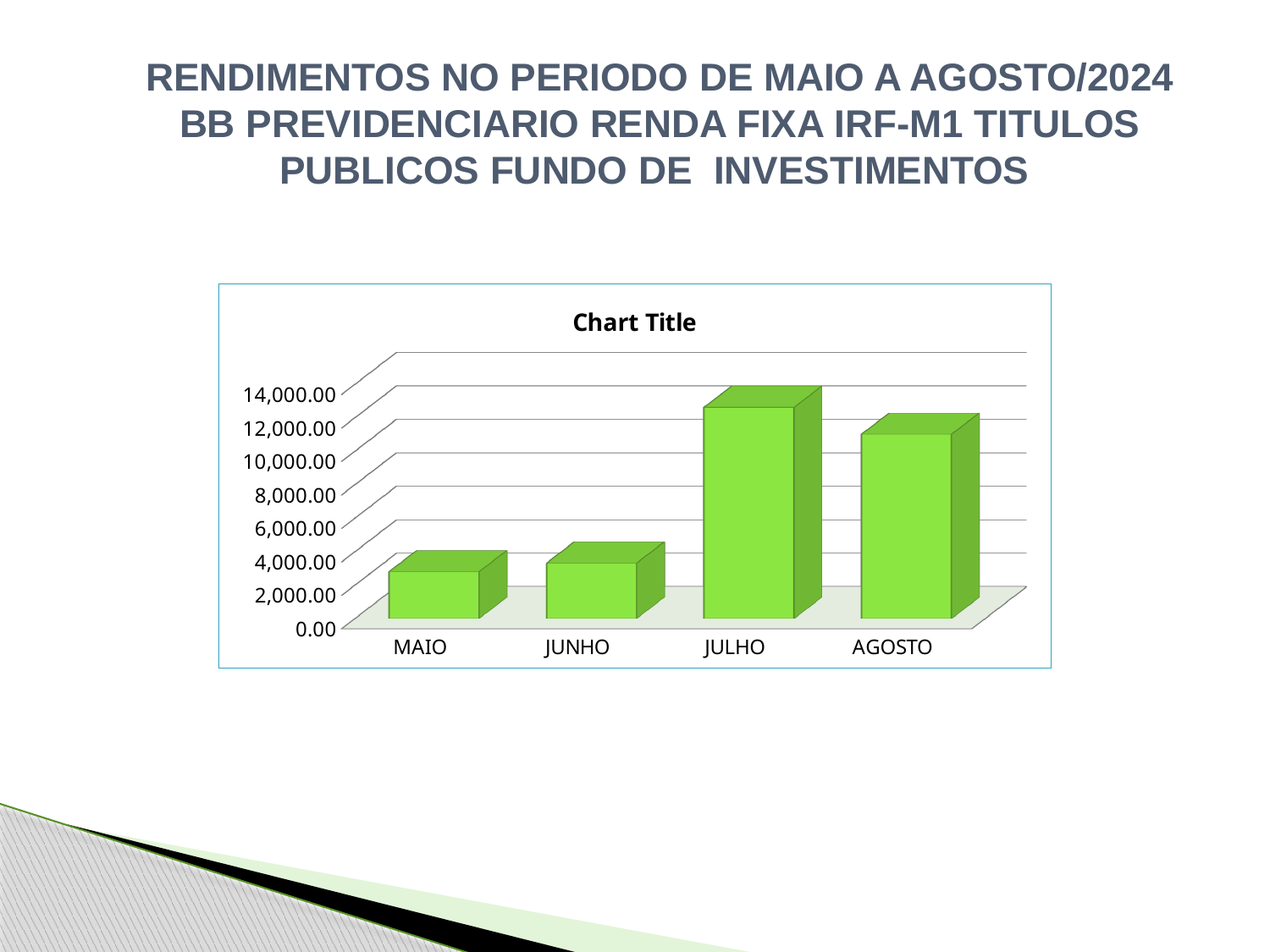
How many categories are shown on the x axis of the chart? 4 Is the value for JUNHO greater or less than 2,000.00? greater Does the value rise or fall from JUNHO to JULHO? rise Is the value for AGOSTO greater or less than 8,000.00? greater What kind of chart is shown on the slide? bar chart Is the value for JULHO greater or less than 10,000.00? greater Which is larger, the value for MAIO or the value for JULHO? JULHO What title is printed above the plot area of the chart? Chart Title Which month has the highest value in the chart? JULHO Which is larger, the value for JULHO or the value for AGOSTO? JULHO Which month has the lowest value in the chart? MAIO